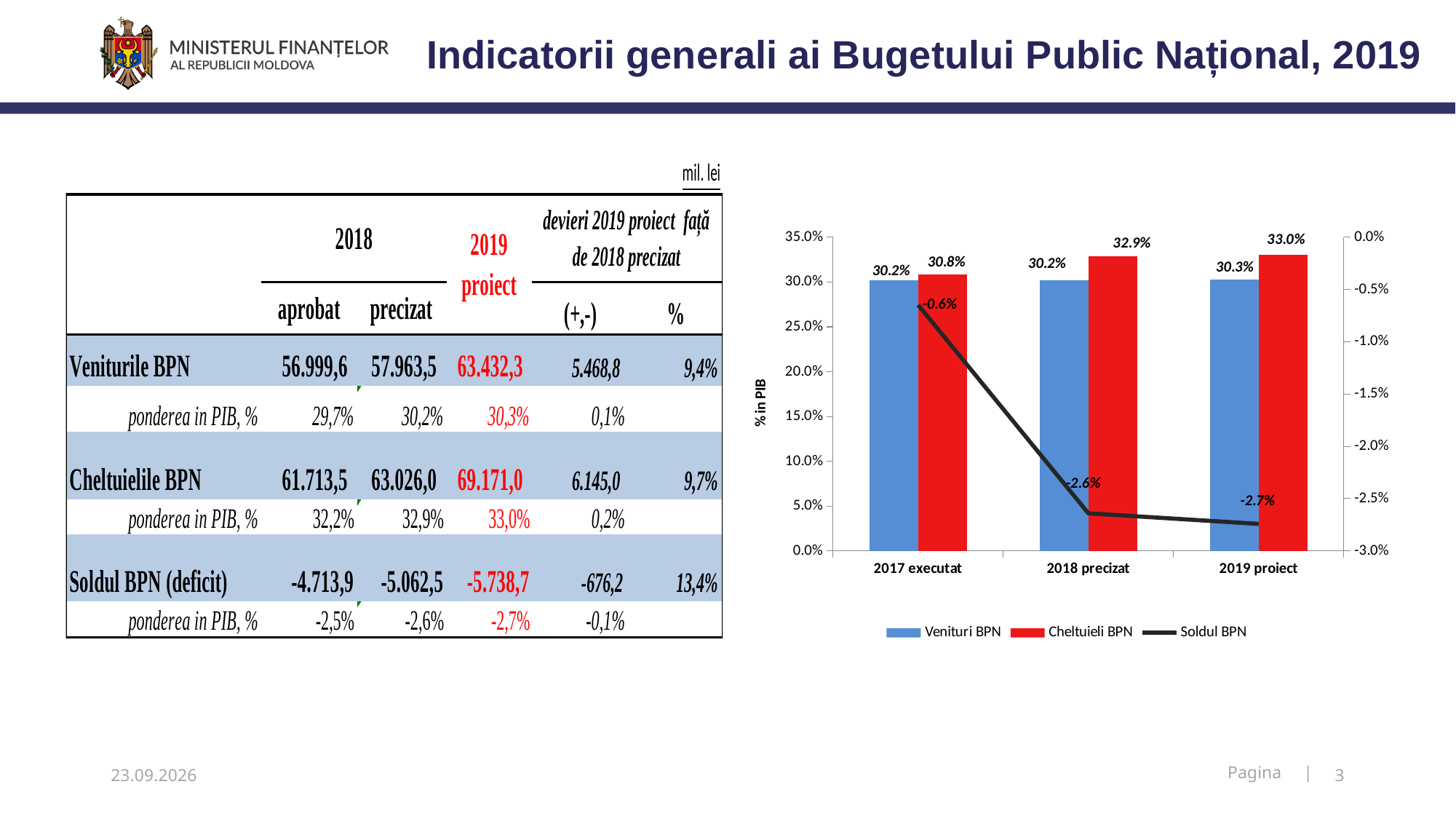
In which category is Soldul BPN lowest in the chart? 2019 proiect Which is larger for 2018 precizat in the chart: Venituri BPN or Cheltuieli BPN? Cheltuieli BPN How many series does the chart legend list? 3 Does Soldul BPN rise or fall from 2017 executat to 2019 proiect in the chart? fall What is the value of Soldul BPN for 2017 executat in the chart? -0.6% What is the value of Cheltuieli BPN for 2017 executat in the chart? 30.8% In which category is Cheltuieli BPN highest in the chart? 2019 proiect What is the value of Venituri BPN for 2019 proiect in the chart? 30.3% What is the difference between Cheltuieli BPN and Venituri BPN for 2019 proiect in the chart? 2.7% What is the value of Cheltuieli BPN for 2018 precizat in the chart? 32.9% How many categories are shown on the x axis of the chart? 3 What is the label of the left vertical axis of the chart? % in PIB